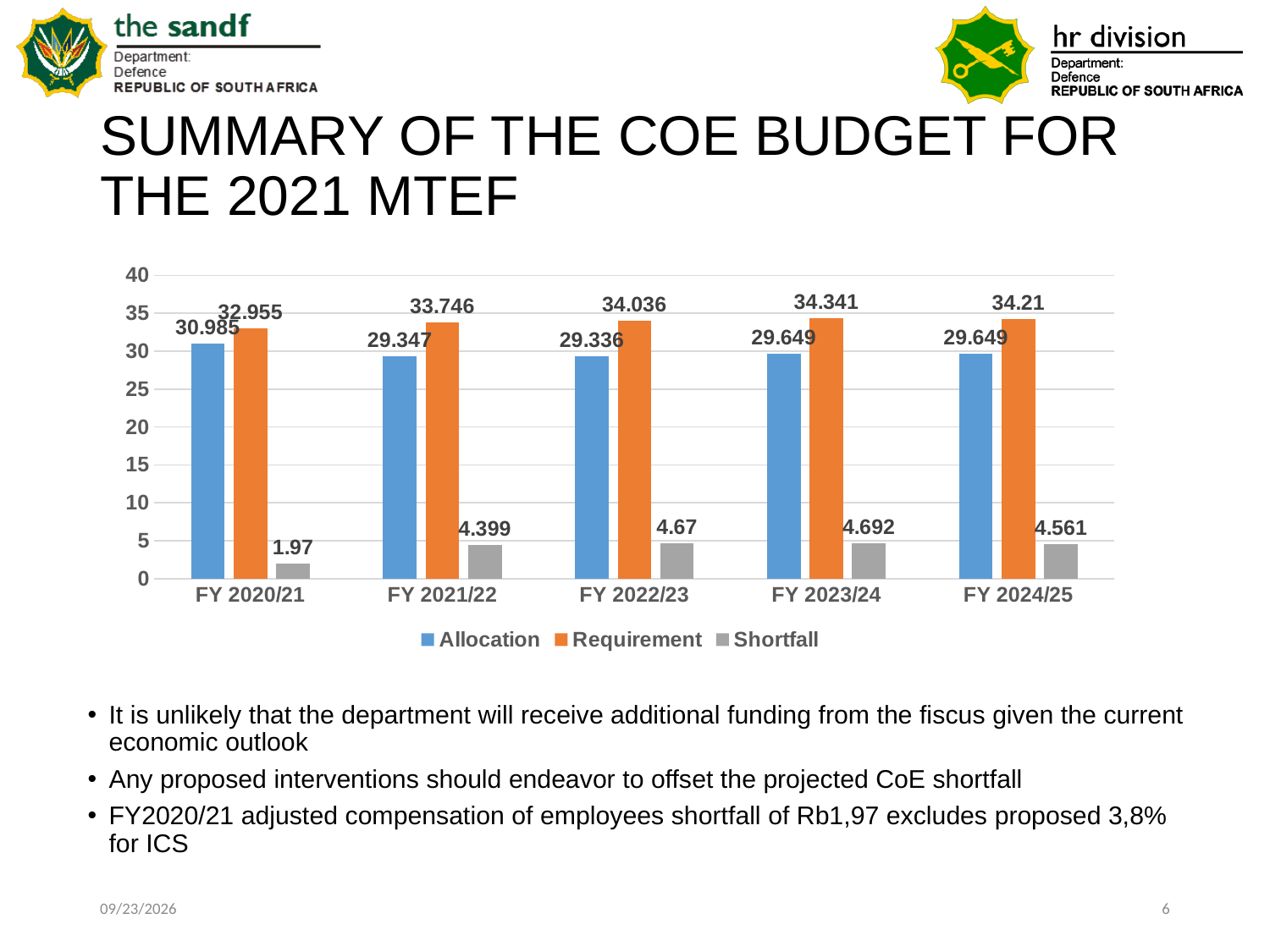
How many financial years are shown on the x axis? 5 What is the difference between the Requirement and the Allocation for FY 2021/22? 4.399 In which financial year is the Requirement highest? FY 2023/24 How many series does the legend list? 3 What type of chart is shown on the slide? Bar chart What is the Requirement value for FY 2022/23? 34.036 In which financial year is the Shortfall lowest? FY 2020/21 Which series is shown in orange in the legend? Requirement What is the Shortfall value for FY 2024/25? 4.561 Which is larger, the Allocation for FY 2020/21 or the Allocation for FY 2023/24? Allocation for FY 2020/21 What is the Allocation value for FY 2020/21? 30.985 Is the Shortfall value for FY 2022/23 greater or less than 5? less